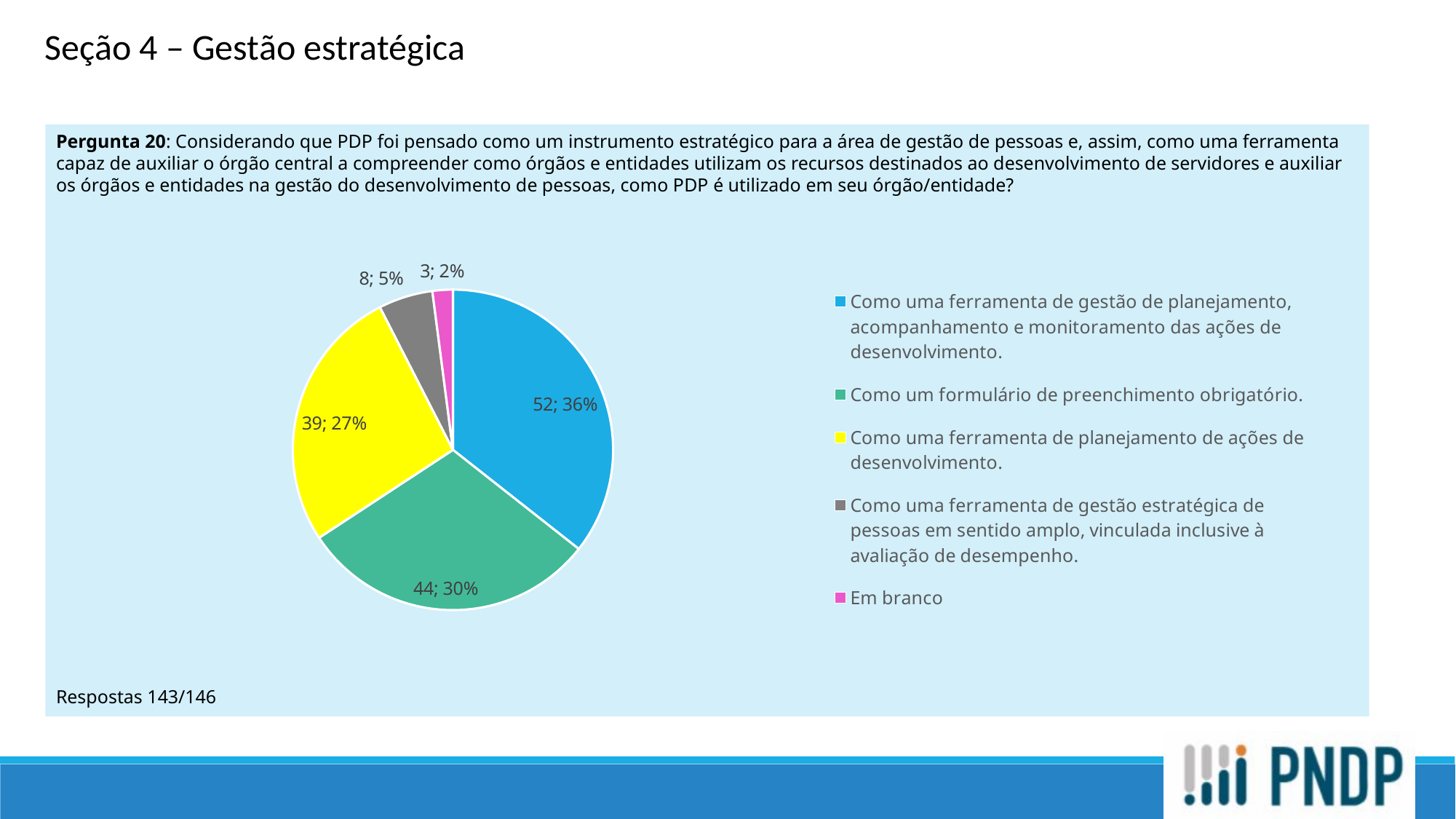
What type of chart is shown on the slide? pie chart What is the difference in responses between the largest slice (52) and the 'Como um formulário de preenchimento obrigatório.' slice (44)? 8 How many slices does the pie chart have? 5 Which category has the smallest slice of the pie? Em branco How many responses are shown for the slice 'Como um formulário de preenchimento obrigatório.'? 44 What share of the pie does the slice 'Como uma ferramenta de planejamento de ações de desenvolvimento.' represent? 27% What colour is the slice for 'Como um formulário de preenchimento obrigatório.'? green Which category has the largest slice of the pie? Como uma ferramenta de gestão de planejamento, acompanhamento e monitoramento das ações de desenvolvimento. How many entries does the legend of the pie chart list? 5 How many responses are shown for the 'Em branco' slice? 3 Which has more responses: 'Como uma ferramenta de gestão estratégica de pessoas em sentido amplo, vinculada inclusive à avaliação de desempenho.' or 'Em branco'? Como uma ferramenta de gestão estratégica de pessoas em sentido amplo, vinculada inclusive à avaliação de desempenho. What share of the pie does the gray slice represent? 5%